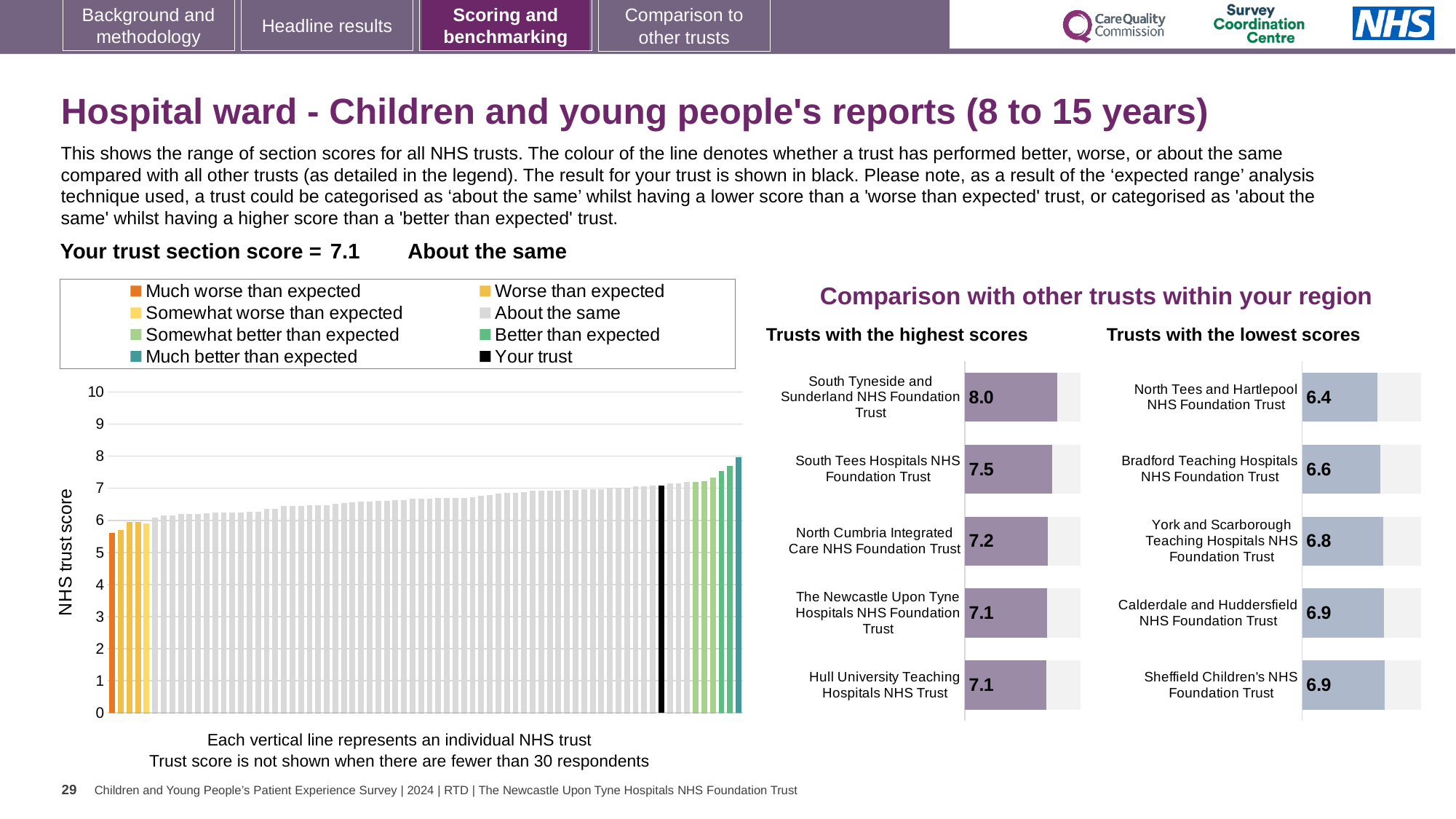
How many entries does the legend of the NHS trust score chart on the left list? 8 In the 'Trusts with the lowest scores' chart, which trust has the lowest score? North Tees and Hartlepool NHS Foundation Trust In the NHS trust score chart on the left, what colour is the bar for your trust? Black In the 'Trusts with the lowest scores' chart, which has the higher score: York and Scarborough Teaching Hospitals NHS Foundation Trust or Bradford Teaching Hospitals NHS Foundation Trust? York and Scarborough Teaching Hospitals NHS Foundation Trust In the 'Trusts with the highest scores' chart, what is the score for South Tyneside and Sunderland NHS Foundation Trust? 8.0 In the 'Trusts with the lowest scores' chart, what is the score for Bradford Teaching Hospitals NHS Foundation Trust? 6.6 In the NHS trust score chart on the left, do the bar heights rise or fall from left to right? Rise How many trusts are shown in the 'Trusts with the highest scores' chart? 5 What kind of chart is the NHS trust score chart on the left of the slide? Bar chart In the NHS trust score chart on the left, is the value of the tallest bar greater or less than 7? greater In the 'Trusts with the highest scores' chart, what is the difference between the scores of South Tyneside and Sunderland NHS Foundation Trust and South Tees Hospitals NHS Foundation Trust? 0.5 In the 'Trusts with the highest scores' chart, which trust has the highest score? South Tyneside and Sunderland NHS Foundation Trust